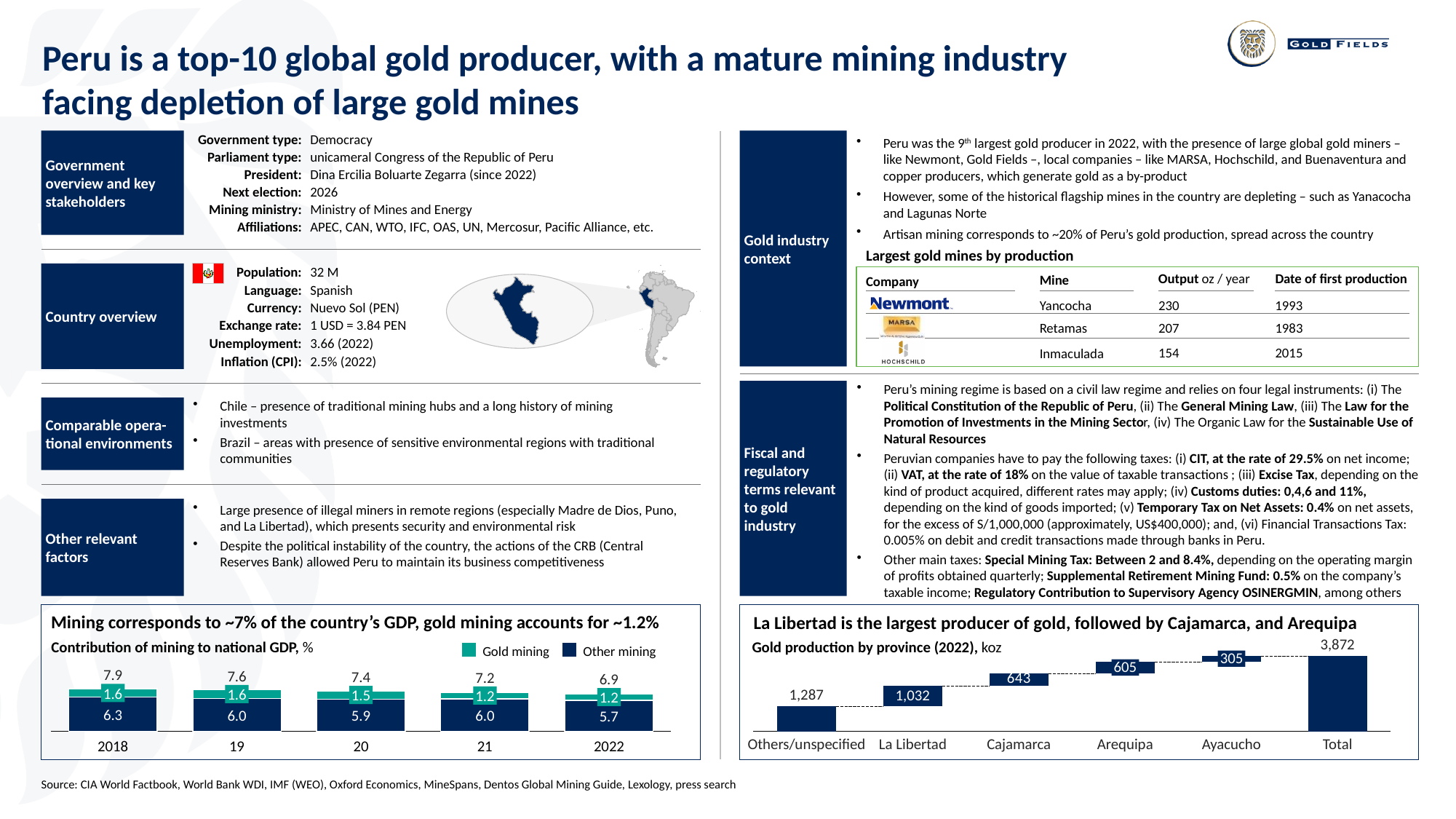
In the 'Gold production by province (2022)' chart, what is the total gold production? 3,872 In the 'Contribution of mining to national GDP' chart, does the total mining contribution rise or fall from 2018 to 2022? fall In the 'Contribution of mining to national GDP' chart, what is the gold mining value for 2018? 1.6 In the 'Contribution of mining to national GDP' chart, which year has the lowest total mining contribution? 2022 In the 'Contribution of mining to national GDP' chart, what is the difference between the other mining values for 2018 and 2019? 0.3 In the 'Contribution of mining to national GDP' chart, what is the other mining value for 2022? 5.7 In the 'Gold production by province (2022)' chart, what is the value for La Libertad? 1,032 In the 'Gold production by province (2022)' chart, what is the difference between La Libertad and Cajamarca? 389 In the 'Gold production by province (2022)' chart, which is larger, Cajamarca or Arequipa? Cajamarca In the 'Gold production by province (2022)' chart, which named province has the lowest production? Ayacucho In the 'Contribution of mining to national GDP' chart, what is the total contribution of mining to GDP in 2020? 7.4 In the 'Contribution of mining to national GDP' chart, how many series does the legend list? 2